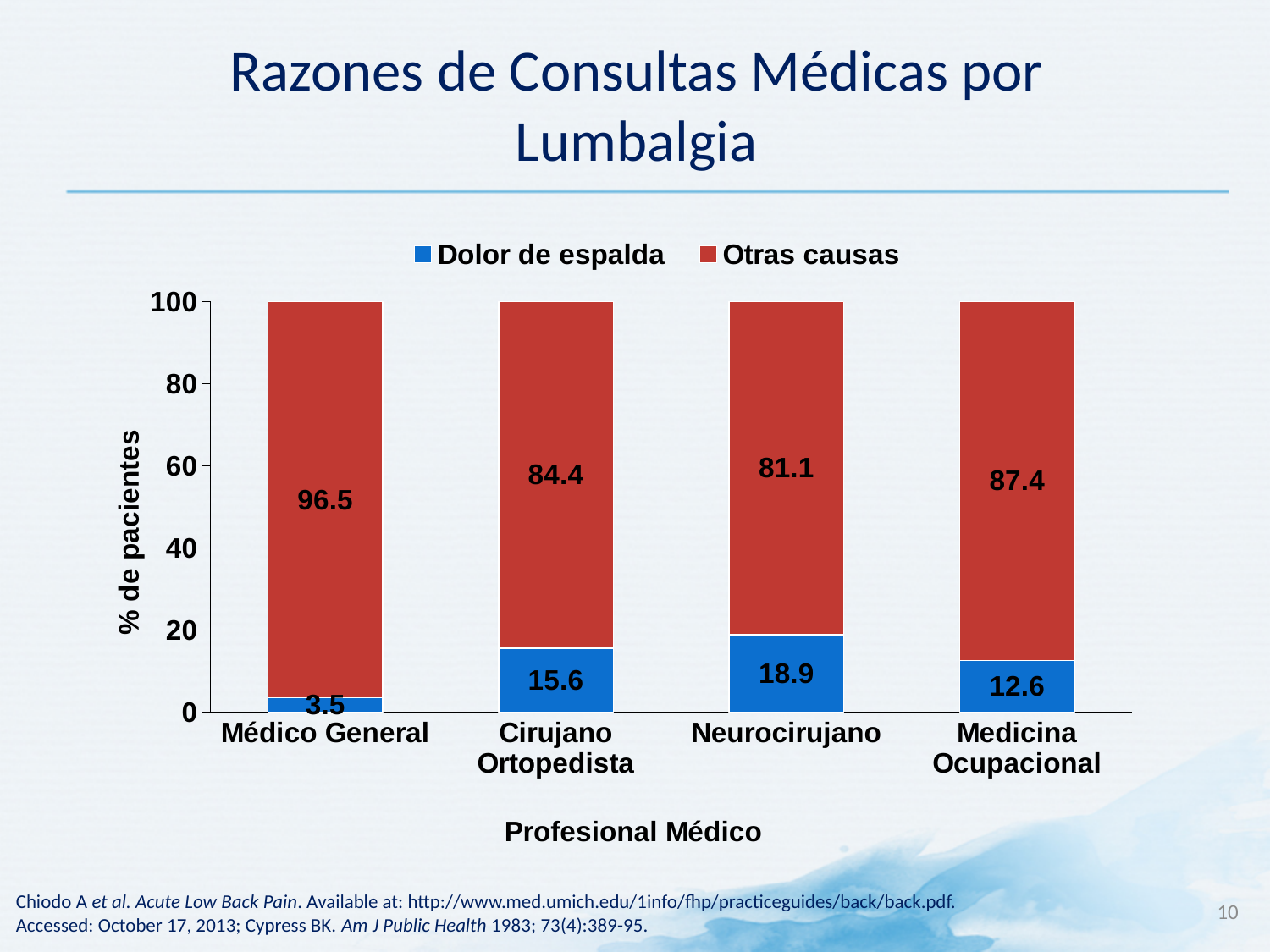
How many series does the legend list? 2 What is the value for Otras causas for Médico General? 96.5 Which professional has the highest value for Dolor de espalda? Neurocirujano What kind of chart is shown on the slide? Stacked bar chart How many professional categories are shown on the x axis? 4 What is the value for Otras causas for Medicina Ocupacional? 87.4 Which professional has the lowest value for Dolor de espalda? Médico General Which is larger: the Otras causas value for Cirujano Ortopedista or for Medicina Ocupacional? Medicina Ocupacional What is the value for Dolor de espalda for Neurocirujano? 18.9 What is the difference between the Dolor de espalda values for Neurocirujano and Cirujano Ortopedista? 3.3 What is the value for Dolor de espalda for Cirujano Ortopedista? 15.6 What is the total of the stacked bar for Cirujano Ortopedista? 100